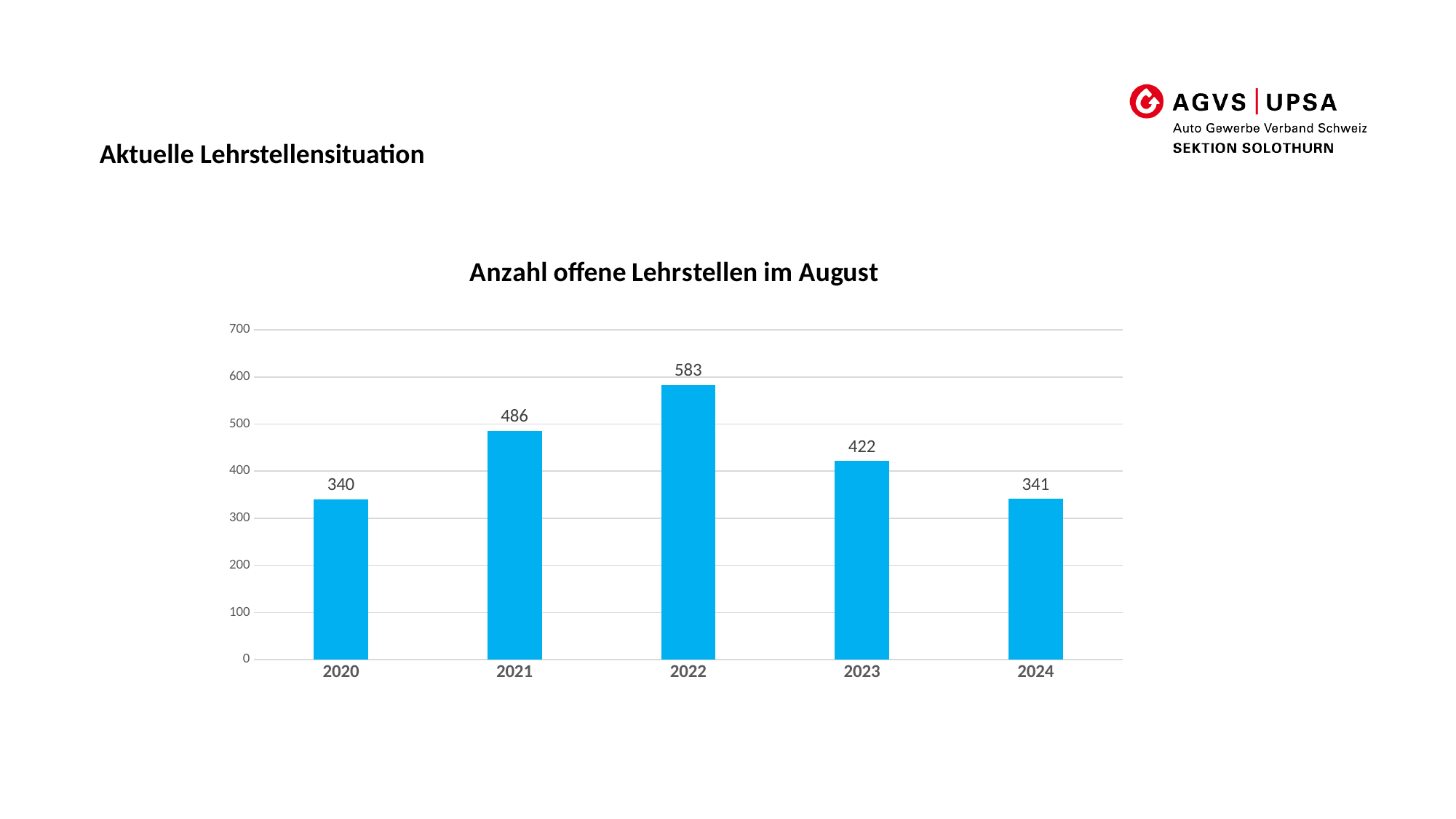
What is the value for 2023? 422 What is the difference between the values for 2022 and 2021? 97 What is the value for 2020? 340 Which year has the lowest value? 2020 Which year has the highest value? 2022 Which is larger, the value for 2021 or the value for 2023? 2021 How many years are shown on the x axis? 5 What is the difference between the values for 2023 and 2024? 81 What is the value for 2022? 583 What kind of chart is shown? Bar chart What is the title of the chart? Anzahl offene Lehrstellen im August Is the value for 2021 greater or less than 400? greater